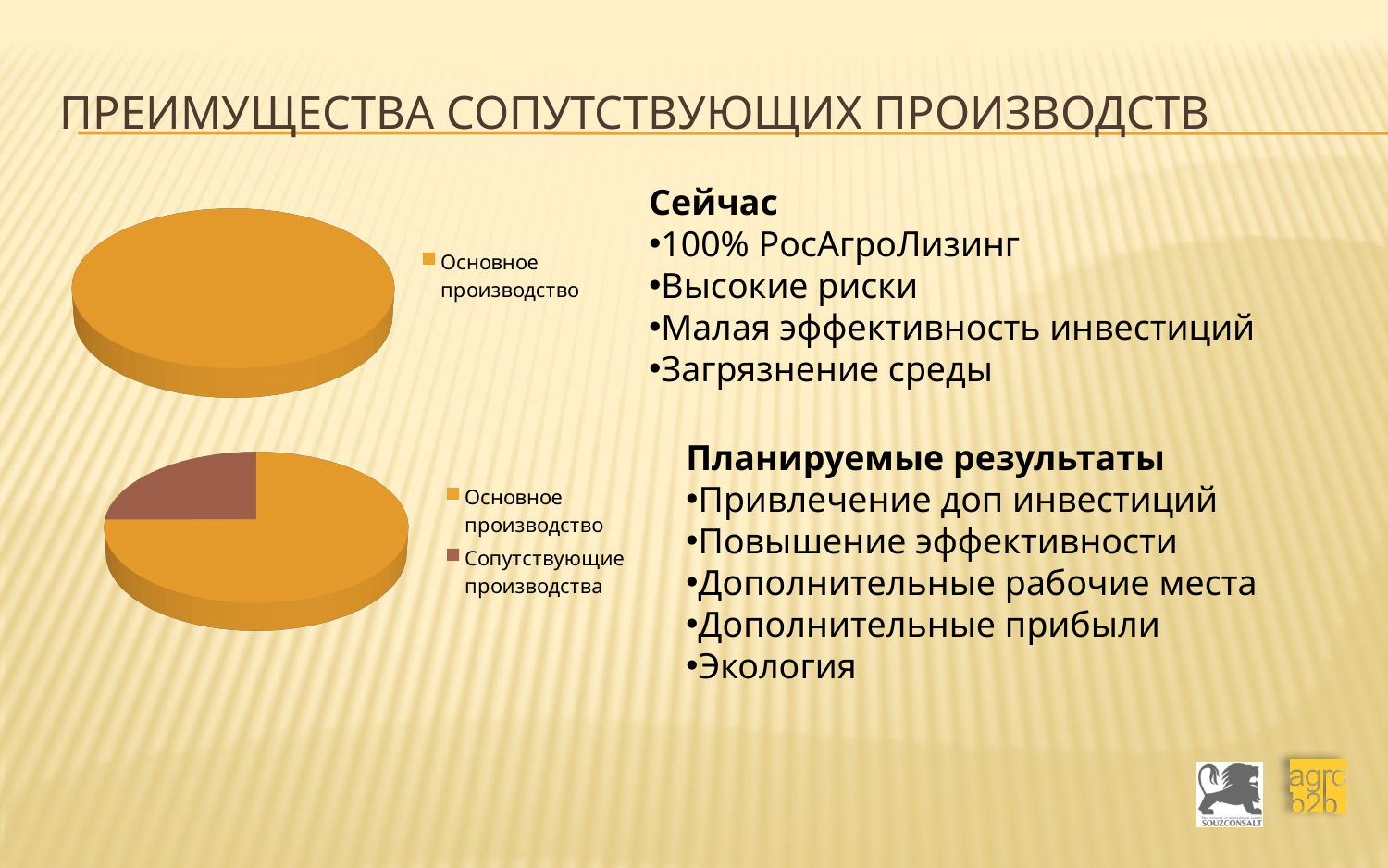
What kind of chart is the bottom chart on the left of the slide? pie chart In the bottom pie chart, how many slices are there? 2 What is the only legend entry of the top pie chart? Основное производство In the bottom pie chart, which slice is larger: Основное производство or Сопутствующие производства? Основное производство In the top pie chart, how many slices are there? 1 In the top pie chart, how many entries does the legend list? 1 In the bottom pie chart, what colour is the slice for Сопутствующие производства? brown In the bottom pie chart, which category has the smallest slice? Сопутствующие производства What kind of chart is the top chart on the left of the slide? pie chart In the bottom pie chart, which category has the largest slice? Основное производство In the bottom pie chart, how many entries does the legend list? 2